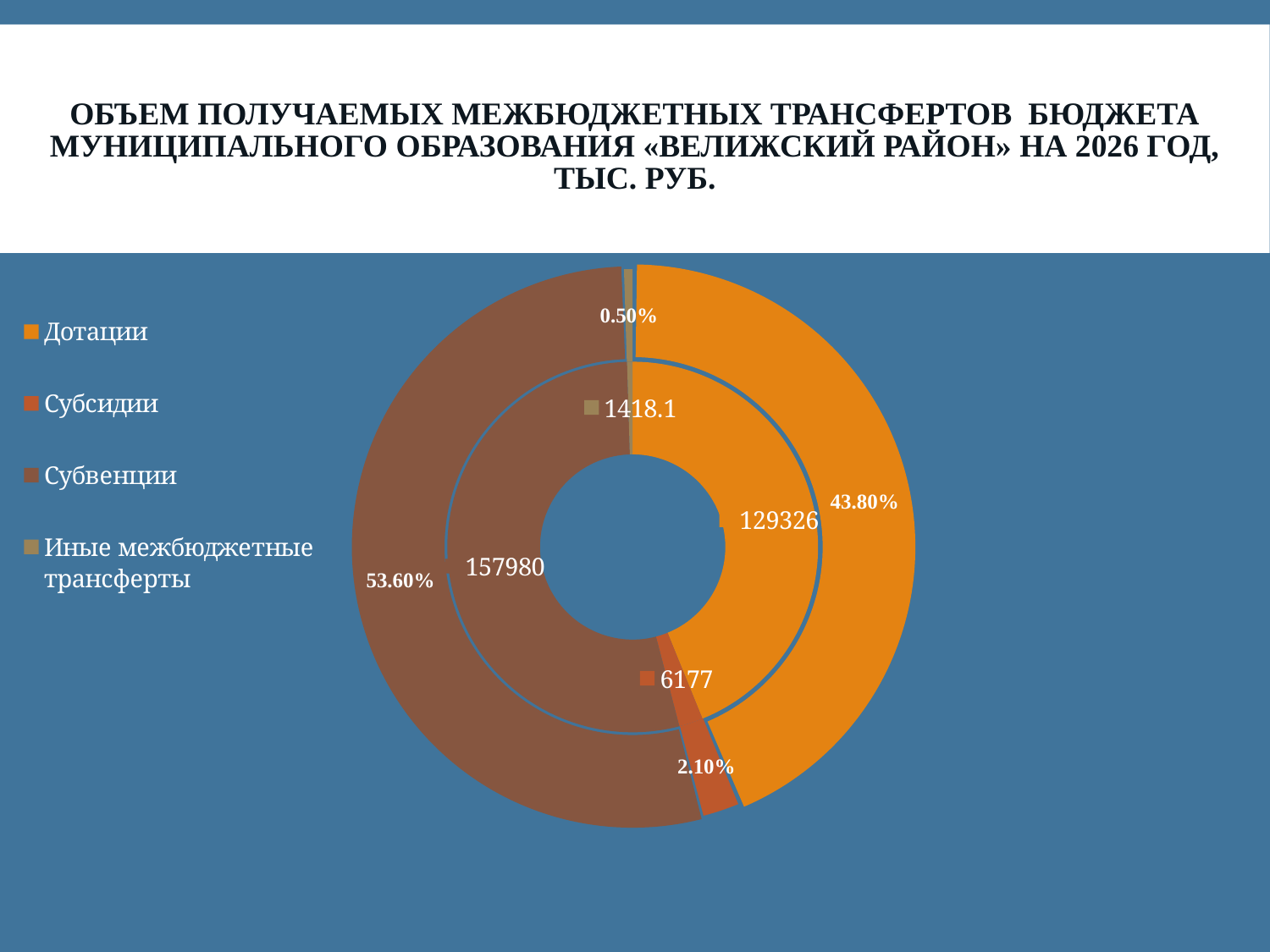
What kind of chart is shown on the slide? doughnut chart What is the difference between the values for Субвенции and Дотации? 28654 Which category has the smallest value? Иные межбюджетные трансферты How many categories does the legend list? 4 Which category has the largest value? Субвенции What is the value for Субвенции (in thousand rubles)? 157980 What is the value for Субсидии (in thousand rubles)? 6177 Which is larger, the value for Субсидии or the value for Иные межбюджетные трансферты? Субсидии What share of the total do Дотации make up? 43.80% What share of the total do Субвенции make up? 53.60% What is the value for Иные межбюджетные трансферты (in thousand rubles)? 1418.1 What is the value for Дотации (in thousand rubles)? 129326